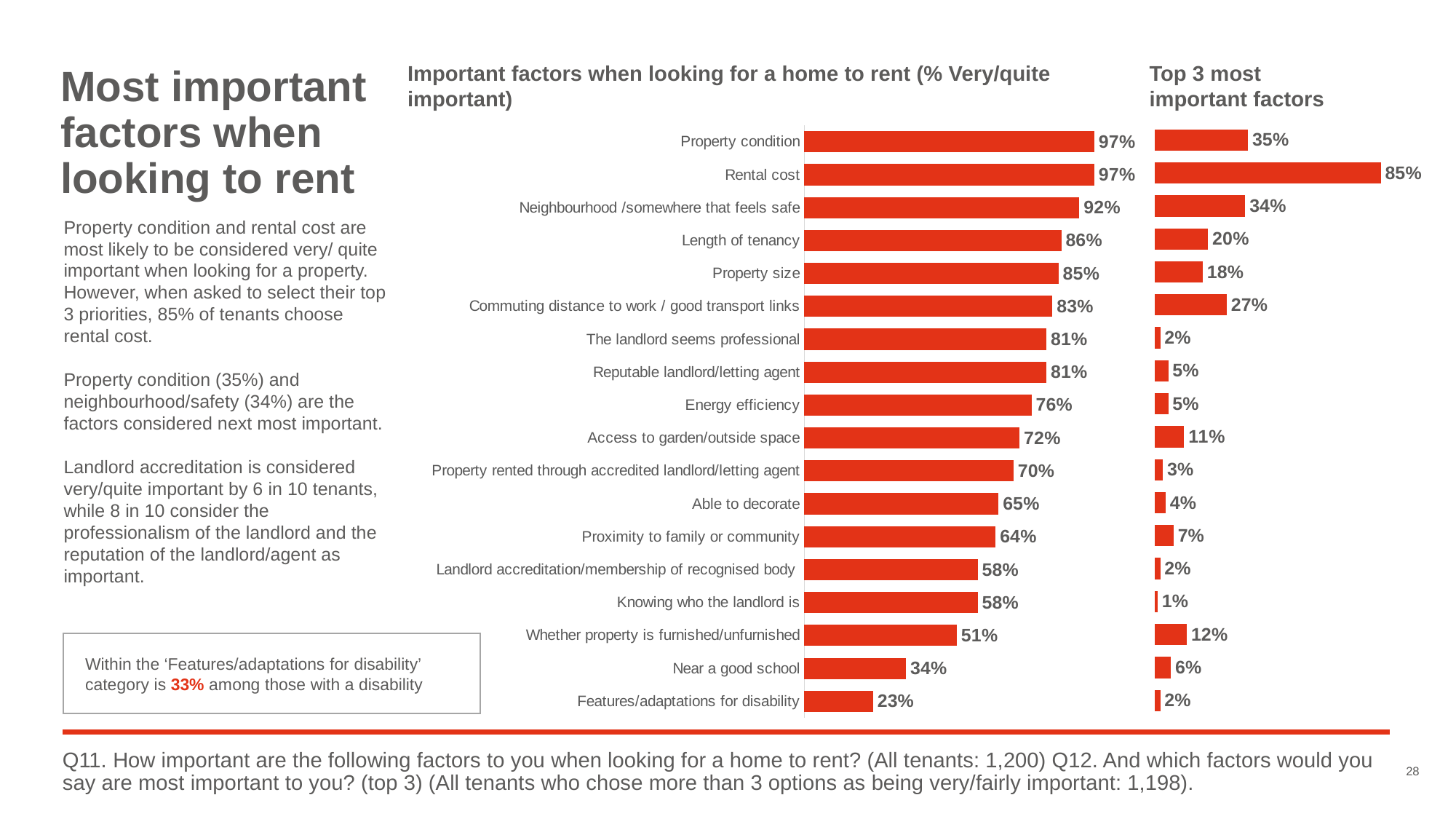
In the 'Top 3 most important factors' chart, what is the difference between Property condition and Neighbourhood /somewhere that feels safe? 1 percentage point In the 'Important factors when looking for a home to rent (% Very/quite important)' chart, what is the value for Energy efficiency? 76% In the 'Top 3 most important factors' chart, what is the value for Rental cost? 85% In the 'Important factors when looking for a home to rent (% Very/quite important)' chart, what is the difference between Neighbourhood /somewhere that feels safe and Near a good school? 58 percentage points In the 'Top 3 most important factors' chart, which is larger: Commuting distance to work / good transport links or Length of tenancy? Commuting distance to work / good transport links How many factors are listed in the 'Important factors when looking for a home to rent (% Very/quite important)' chart? 18 In the 'Important factors when looking for a home to rent (% Very/quite important)' chart, which factor has the lowest value? Features/adaptations for disability What type of chart is the 'Top 3 most important factors' chart? Bar chart In the 'Important factors when looking for a home to rent (% Very/quite important)' chart, which is larger: Able to decorate or Whether property is furnished/unfurnished? Able to decorate In the 'Top 3 most important factors' chart, which factor has the highest value? Rental cost In the 'Top 3 most important factors' chart, which factor has the lowest value? Knowing who the landlord is In the 'Important factors when looking for a home to rent (% Very/quite important)' chart, what is the value for Access to garden/outside space? 72%